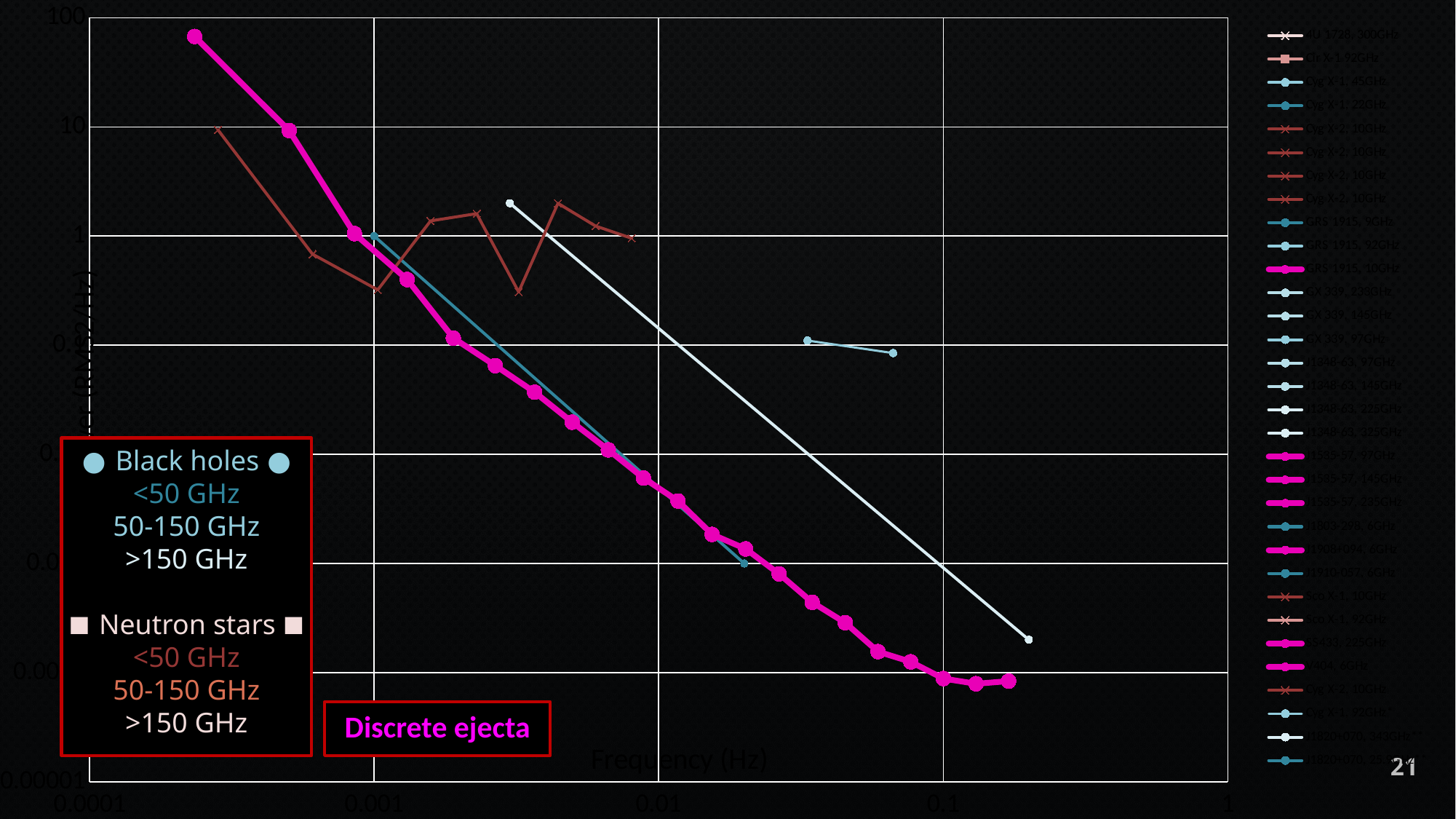
Does the long light-blue line rise or fall as frequency increases? fall What is the label on the x axis of the chart? Frequency (Hz) Is the value of the rightmost point on the long light-blue line greater or less than 0.01? less What text appears in the magenta label box near the bottom of the chart? Discrete ejecta Does the thick magenta line rise or fall as frequency increases along the x axis? fall Is the value of the thick magenta line at a frequency of 0.01 Hz greater or less than 0.01? less What kind of chart is shown on the slide? line chart Is the value of the leftmost point on the thick magenta line greater or less than 10? greater